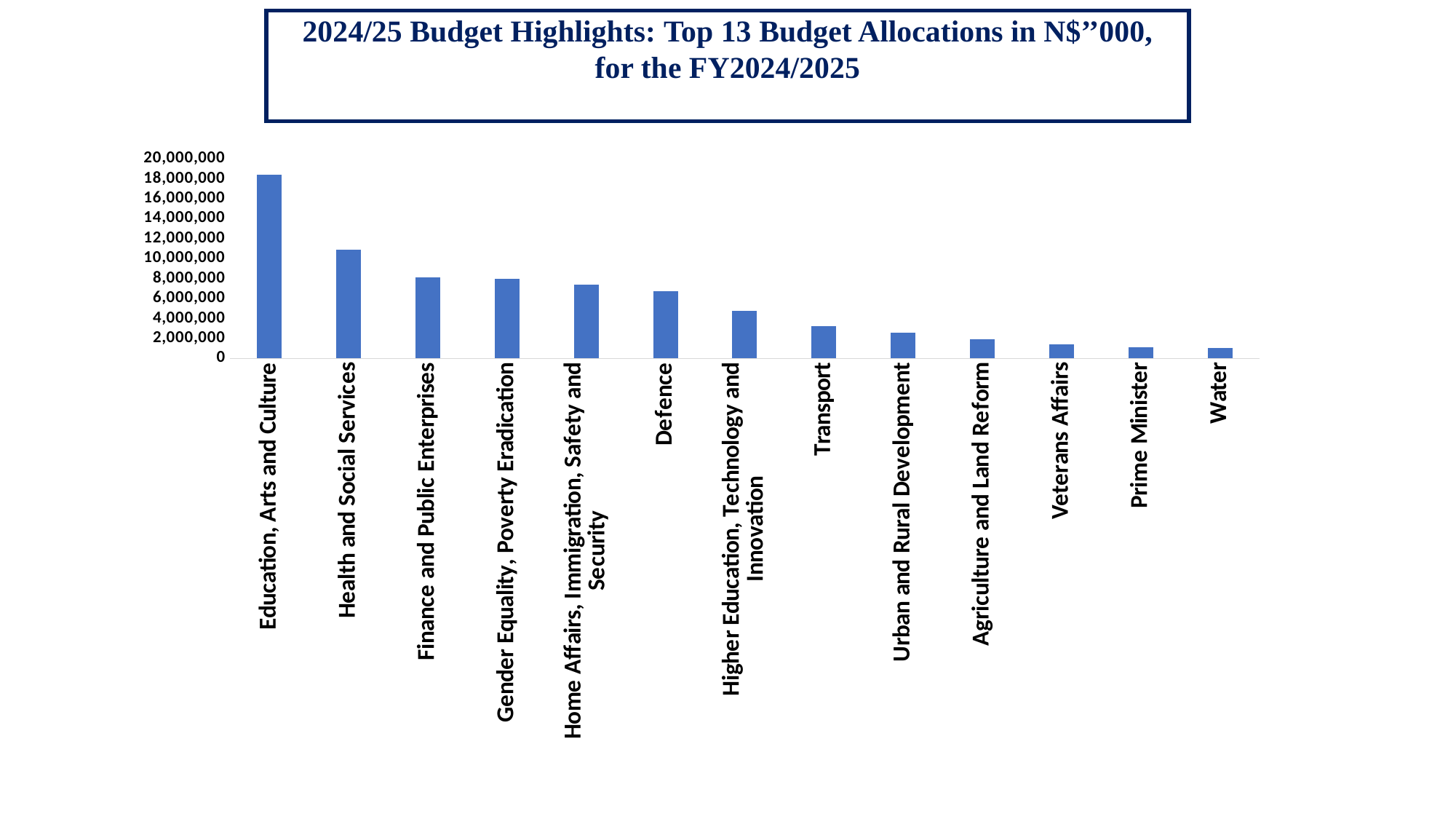
Is the value for Higher Education, Technology and Innovation greater or less than 4,000,000? greater How many categories are plotted on the chart? 13 Is the value for Health and Social Services greater or less than 10,000,000? greater Is the value for Transport greater or less than 4,000,000? less What is the title of the chart? 2024/25 Budget Highlights: Top 13 Budget Allocations in N$"000, for the FY2024/2025 Which category has the highest budget allocation? Education, Arts and Culture What kind of chart is shown on the slide? bar chart Do the values rise or fall moving from left to right along the x axis? fall Which is larger, the allocation for Defence or for Transport? Defence